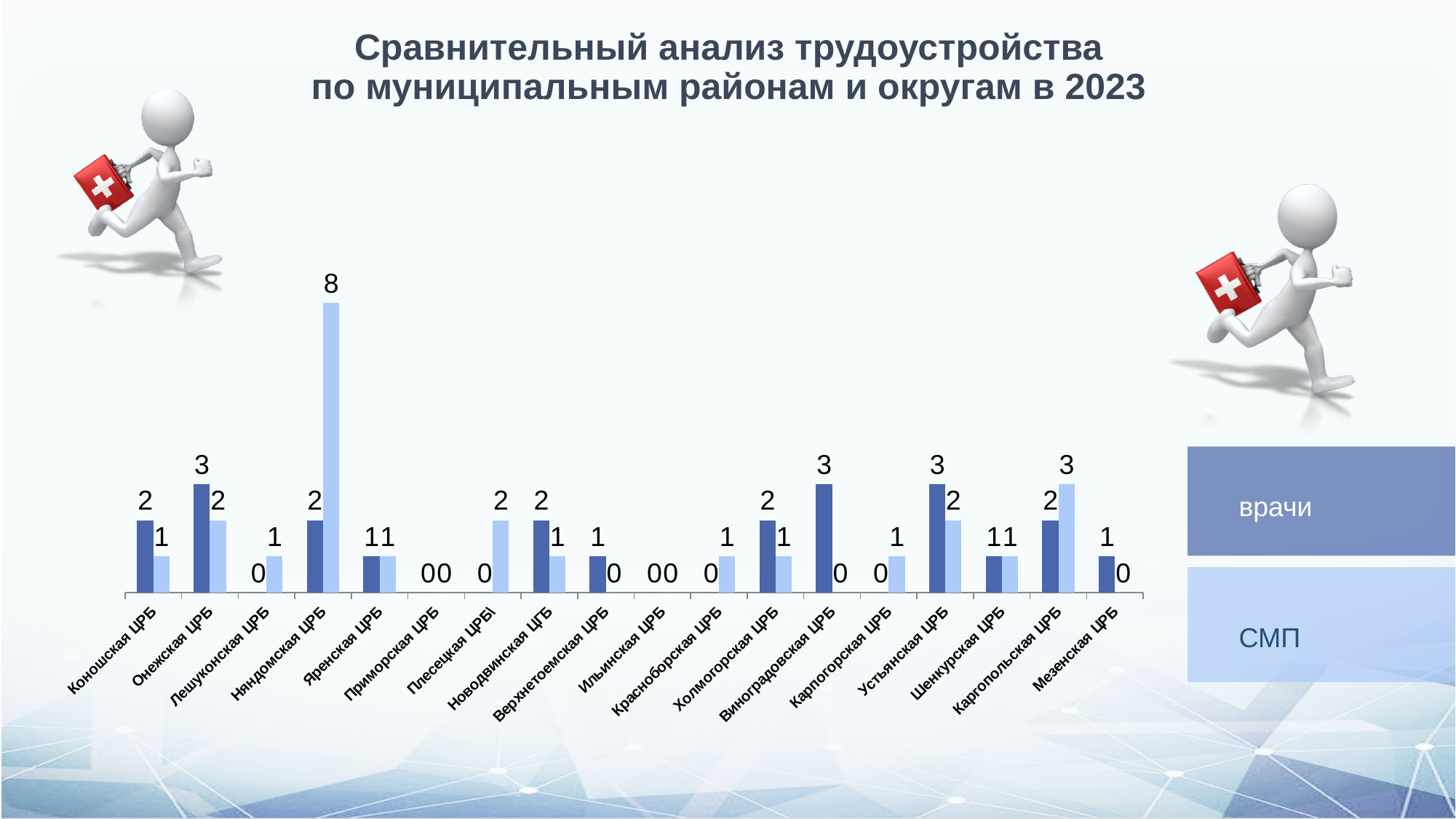
How many categories (hospitals) are shown on the x axis? 18 What is the врачи value for Онежская ЦРБ? 3 What kind of chart is shown on the slide? bar chart What is the СМП value for Плесецкая ЦРБ? 2 What is the врачи value for Виноградовская ЦРБ? 3 Which category has the highest СМП value? Няндомская ЦРБ What is the combined total of врачи and СМП for Устьянская ЦРБ? 5 What is the difference between the СМП and врачи values for Няндомская ЦРБ? 6 What is the СМП value for Няндомская ЦРБ? 8 What are the two series named in the legend? врачи and СМП For Каргопольская ЦРБ, which is larger: врачи or СМП? СМП How many series does the legend list? 2